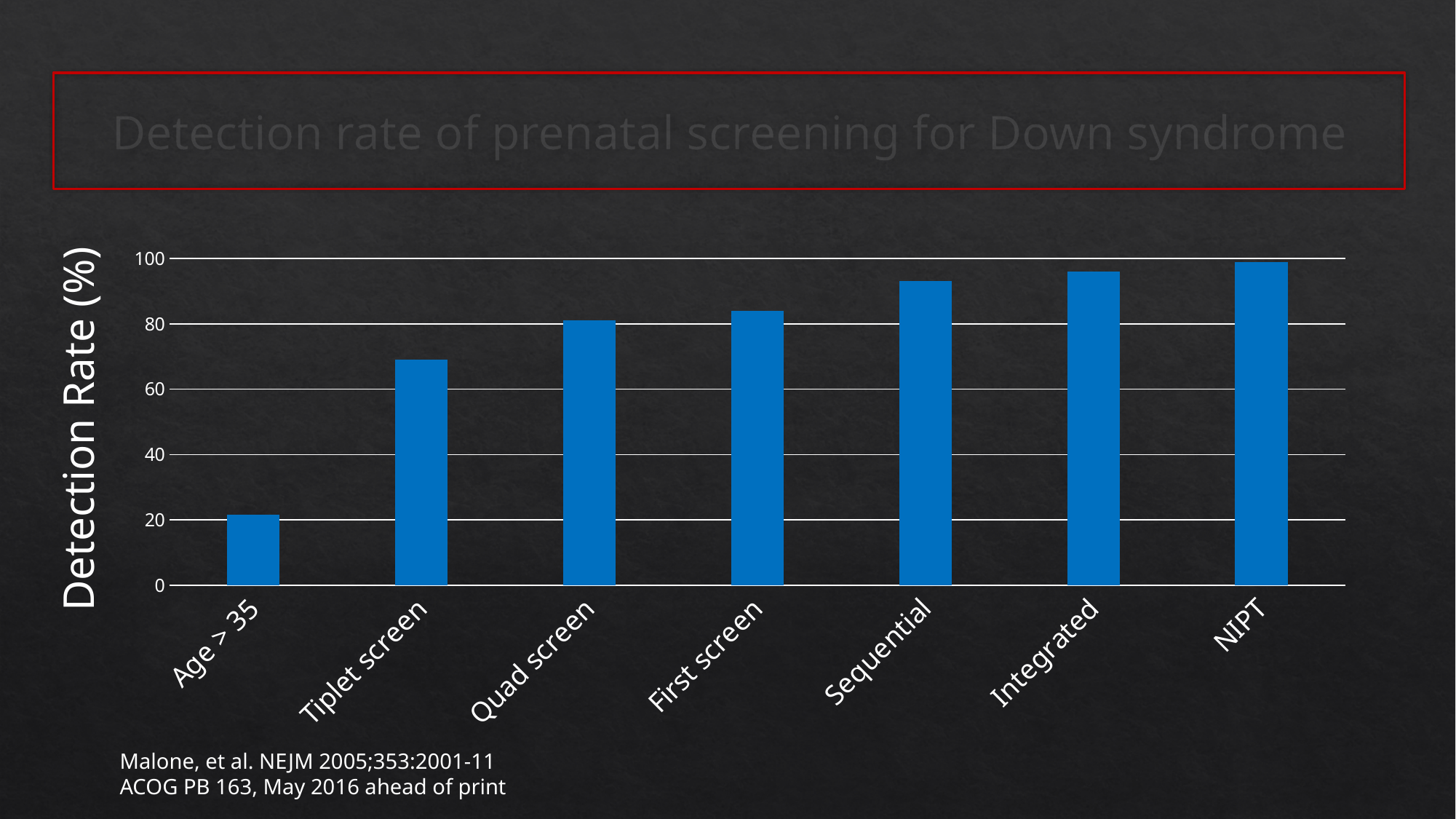
Which category has the lowest detection rate? Age > 35 What is the label on the vertical axis? Detection Rate (%) Is the detection rate for Integrated greater or less than 100? less Is the detection rate for Tiplet screen greater or less than 60? greater What kind of chart is shown on the slide? bar chart Is the detection rate for Age > 35 greater or less than 40? less Which category has the highest detection rate? NIPT How many screening categories are plotted on the x axis? 7 Which has a higher detection rate, Age > 35 or Tiplet screen? Tiplet screen Do the detection rates rise or fall moving from left to right along the x axis? rise